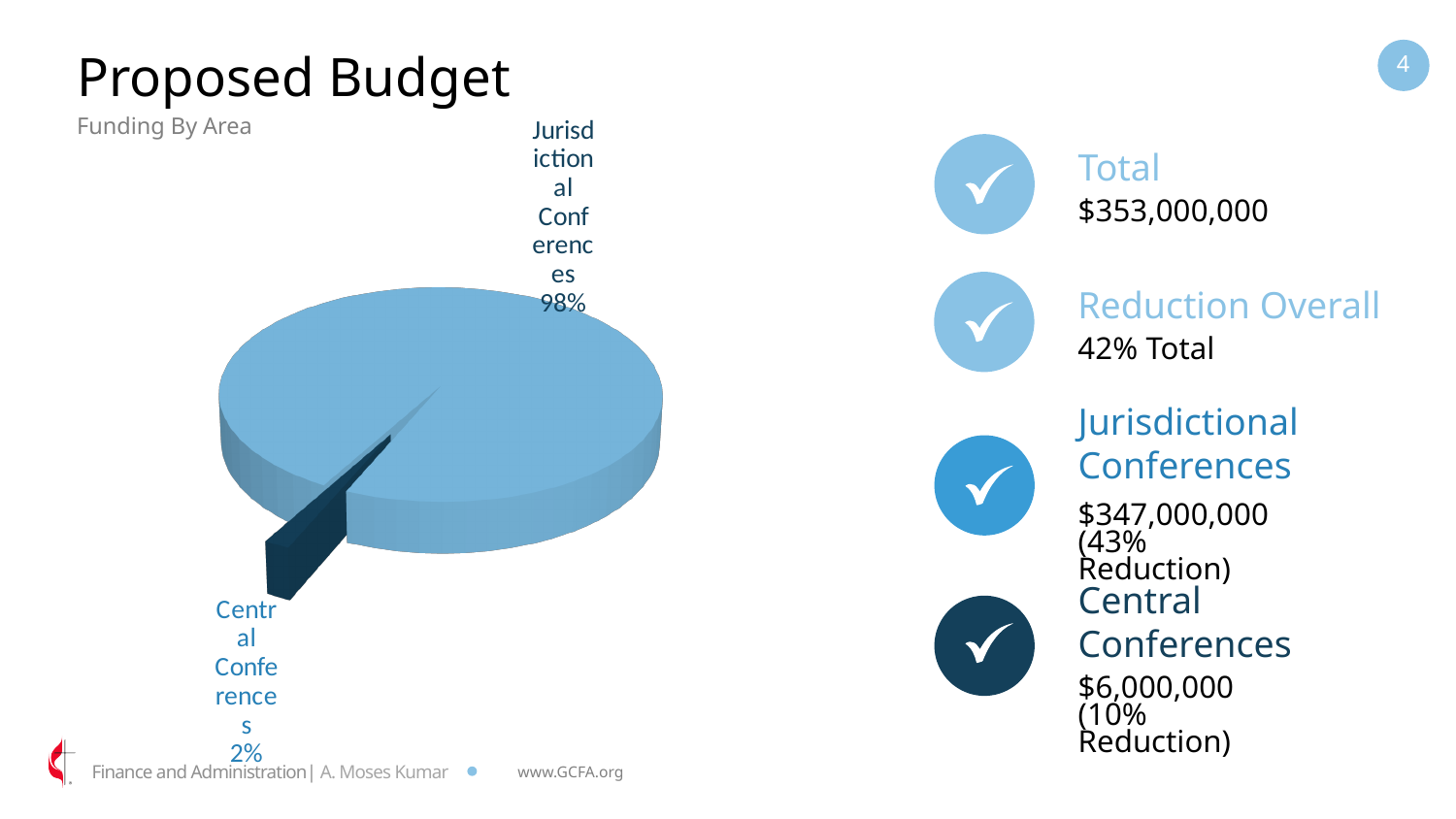
Which slice of the pie chart is the largest? Jurisdictional Conferences What share of the pie does Central Conferences represent? 2% Which slice of the pie chart is the smallest? Central Conferences What share of the pie does Jurisdictional Conferences represent? 98% What kind of chart is shown on the slide? pie chart What is the difference in percentage points between the Jurisdictional Conferences slice and the Central Conferences slice? 96 Which slice is pulled out (exploded) from the pie chart? Central Conferences How many slices does the pie chart have? 2 Which is larger in the pie chart, Jurisdictional Conferences or Central Conferences? Jurisdictional Conferences What is the subtitle shown above the pie chart? Funding By Area